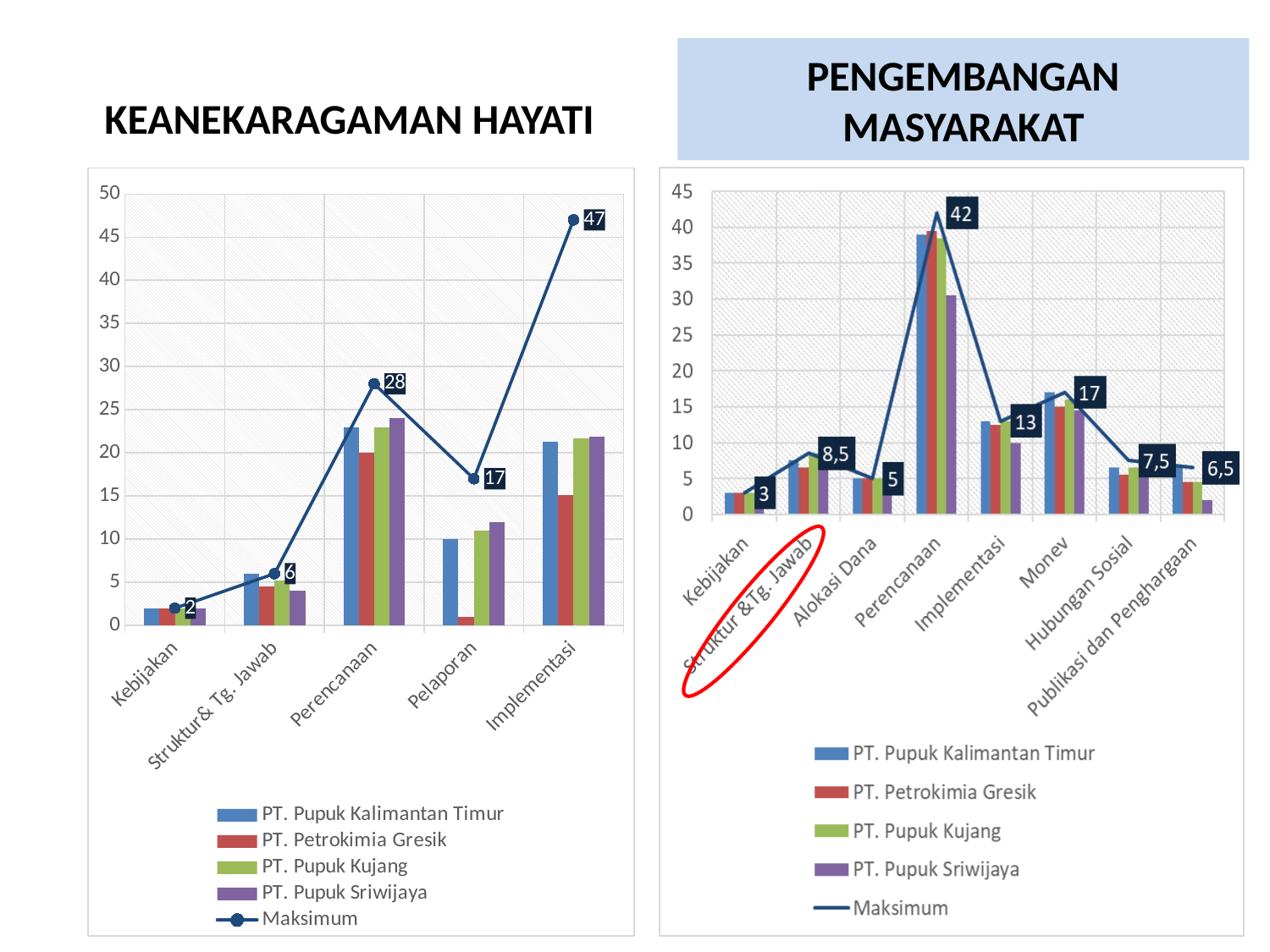
On the PENGEMBANGAN MASYARAKAT chart, which category has the lowest Maksimum value? Kebijakan On the KEANEKARAGAMAN HAYATI chart, how many categories are shown on the x axis? 5 On the KEANEKARAGAMAN HAYATI chart, what is the Maksimum value for Implementasi? 47 On the PENGEMBANGAN MASYARAKAT chart, what is the Maksimum value for Struktur & Tg. Jawab? 8,5 On the KEANEKARAGAMAN HAYATI chart, what is the Maksimum value for Pelaporan? 17 On the PENGEMBANGAN MASYARAKAT chart, is the Maksimum value for Monev larger than the Maksimum value for Implementasi? Yes On the KEANEKARAGAMAN HAYATI chart, what is the difference between the Maksimum values for Implementasi and Perencanaan? 19 On the PENGEMBANGAN MASYARAKAT chart, how many categories are shown on the x axis? 8 On the KEANEKARAGAMAN HAYATI chart, which category has the highest Maksimum value? Implementasi On the KEANEKARAGAMAN HAYATI chart, is the value for PT. Pupuk Kalimantan Timur at Perencanaan greater or less than 20? greater On the PENGEMBANGAN MASYARAKAT chart, what is the Maksimum value for Perencanaan? 42 On the PENGEMBANGAN MASYARAKAT chart, how many series does the legend list? 5